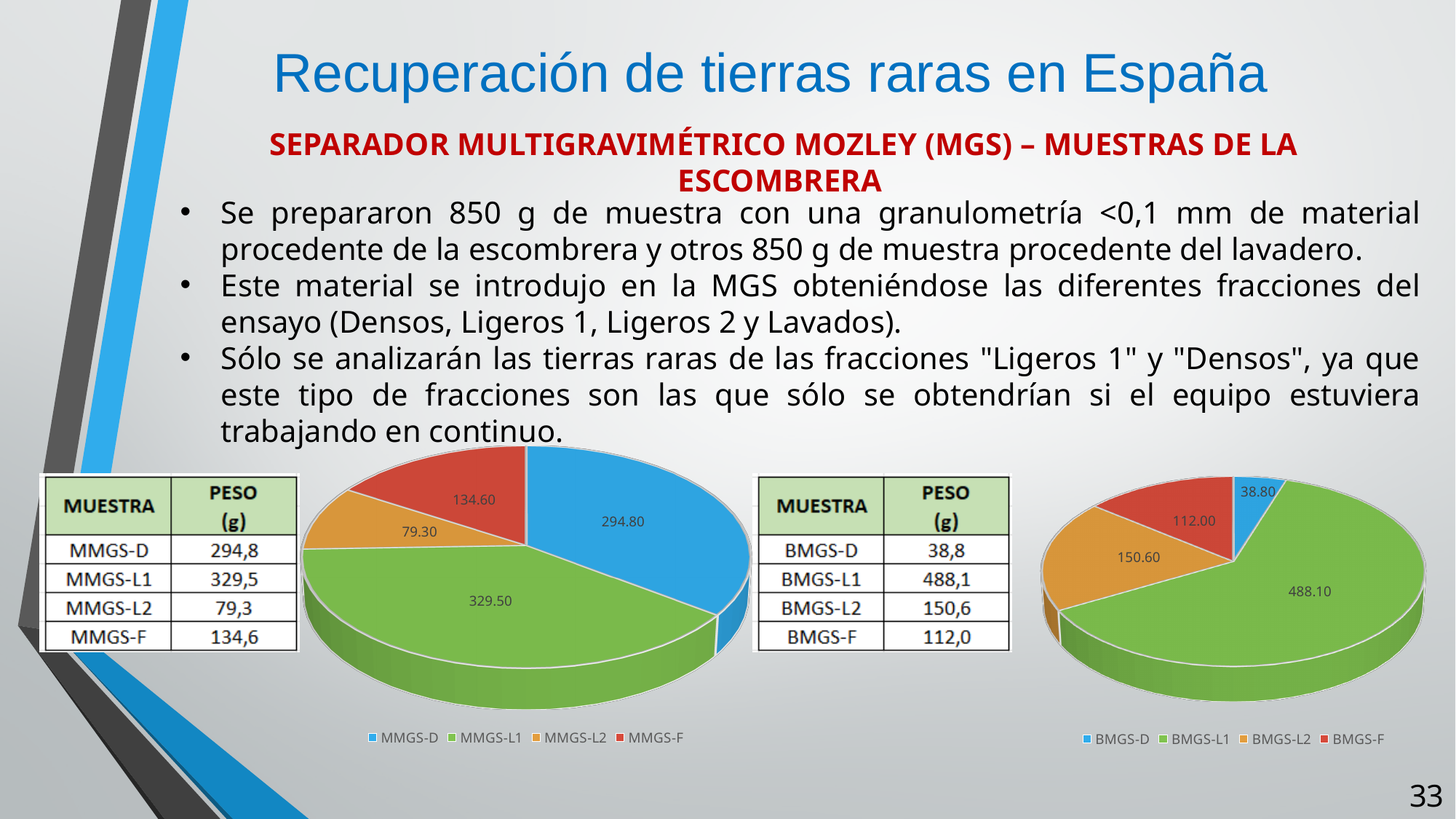
In the left pie chart, which category has the largest slice? MMGS-L1 In the right pie chart, what is the difference between the values for BMGS-L2 and BMGS-F? 38.60 In the right pie chart, what is the value for BMGS-L1? 488.10 How many slices does the left pie chart have? 4 In the left pie chart, what is the value for MMGS-D? 294.80 In the right pie chart, which category has the smallest slice? BMGS-D In the right pie chart, what colour is the BMGS-L1 slice? Green In the right pie chart, which is larger, BMGS-L2 or BMGS-F? BMGS-L2 In the left pie chart, what is the difference between the values for MMGS-L1 and MMGS-D? 34.70 In the right pie chart, what is the value for BMGS-F? 112.00 What type of chart is the right chart on the slide? Pie chart In the left pie chart, what is the value for MMGS-L2? 79.30